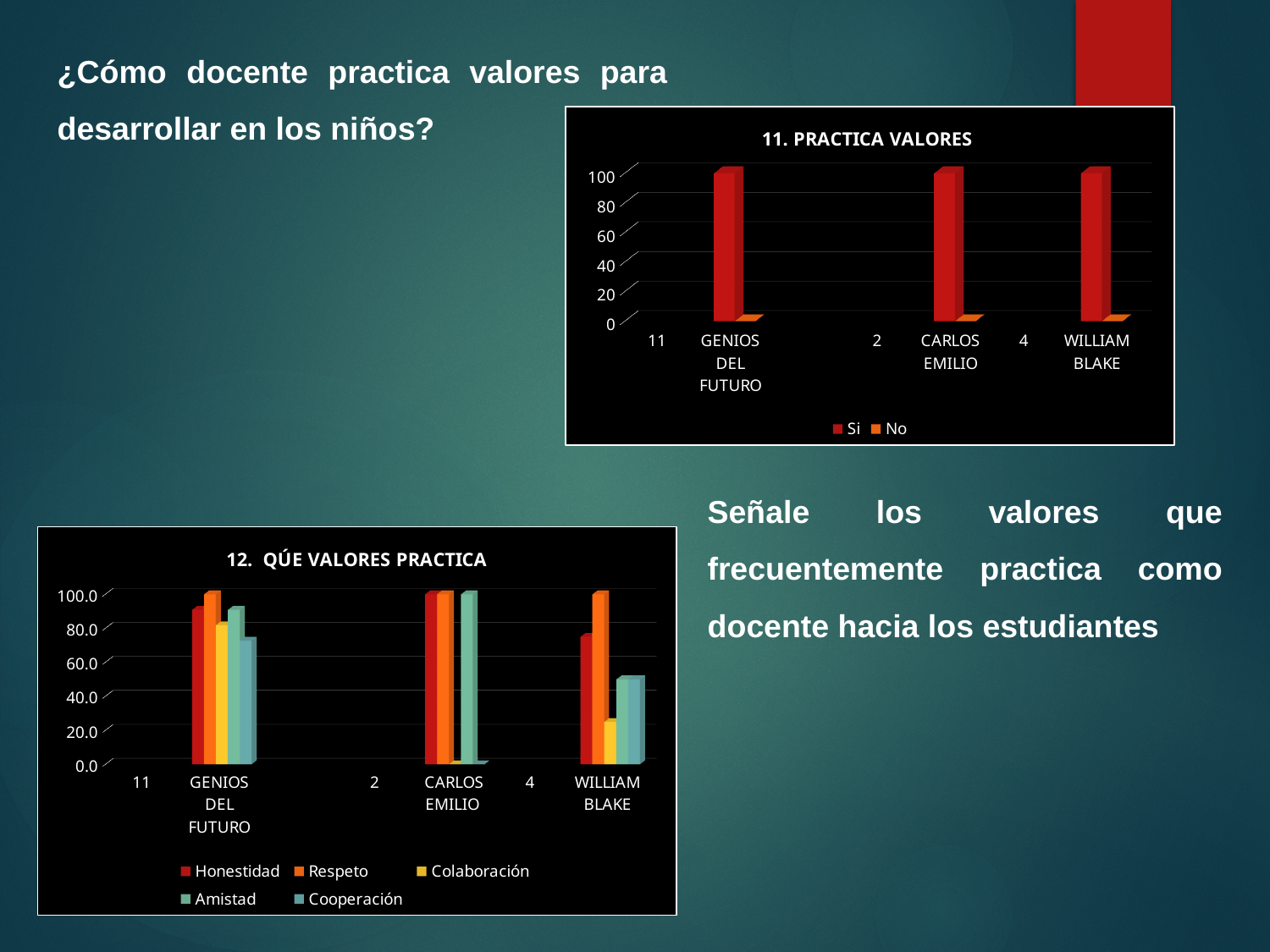
In the chart titled "12. QÚE VALORES PRACTICA", which value has the highest bar for GENIOS DEL FUTURO? Respeto In the chart titled "11. PRACTICA VALORES", which series is larger for WILLIAM BLAKE, Si or No? Si What is the title of the chart in the lower left of the slide? 12. QÚE VALORES PRACTICA In the chart titled "11. PRACTICA VALORES", is the "Si" value for CARLOS EMILIO greater or less than 80? greater How many series does the legend of the chart titled "12. QÚE VALORES PRACTICA" list? 5 In the chart titled "12. QÚE VALORES PRACTICA", is the Cooperación value for WILLIAM BLAKE greater or less than 60.0? less In the chart titled "12. QÚE VALORES PRACTICA", is the Honestidad value for WILLIAM BLAKE greater or less than 60.0? greater In the chart titled "12. QÚE VALORES PRACTICA", which is larger for WILLIAM BLAKE, Respeto or Colaboración? Respeto How many series does the legend of the chart titled "11. PRACTICA VALORES" list? 2 In the chart titled "12. QÚE VALORES PRACTICA", which value has the lowest bar for WILLIAM BLAKE? Colaboración What kind of chart is the chart titled "11. PRACTICA VALORES"? Bar chart In the chart titled "11. PRACTICA VALORES", how many school categories are shown on the x axis? 3